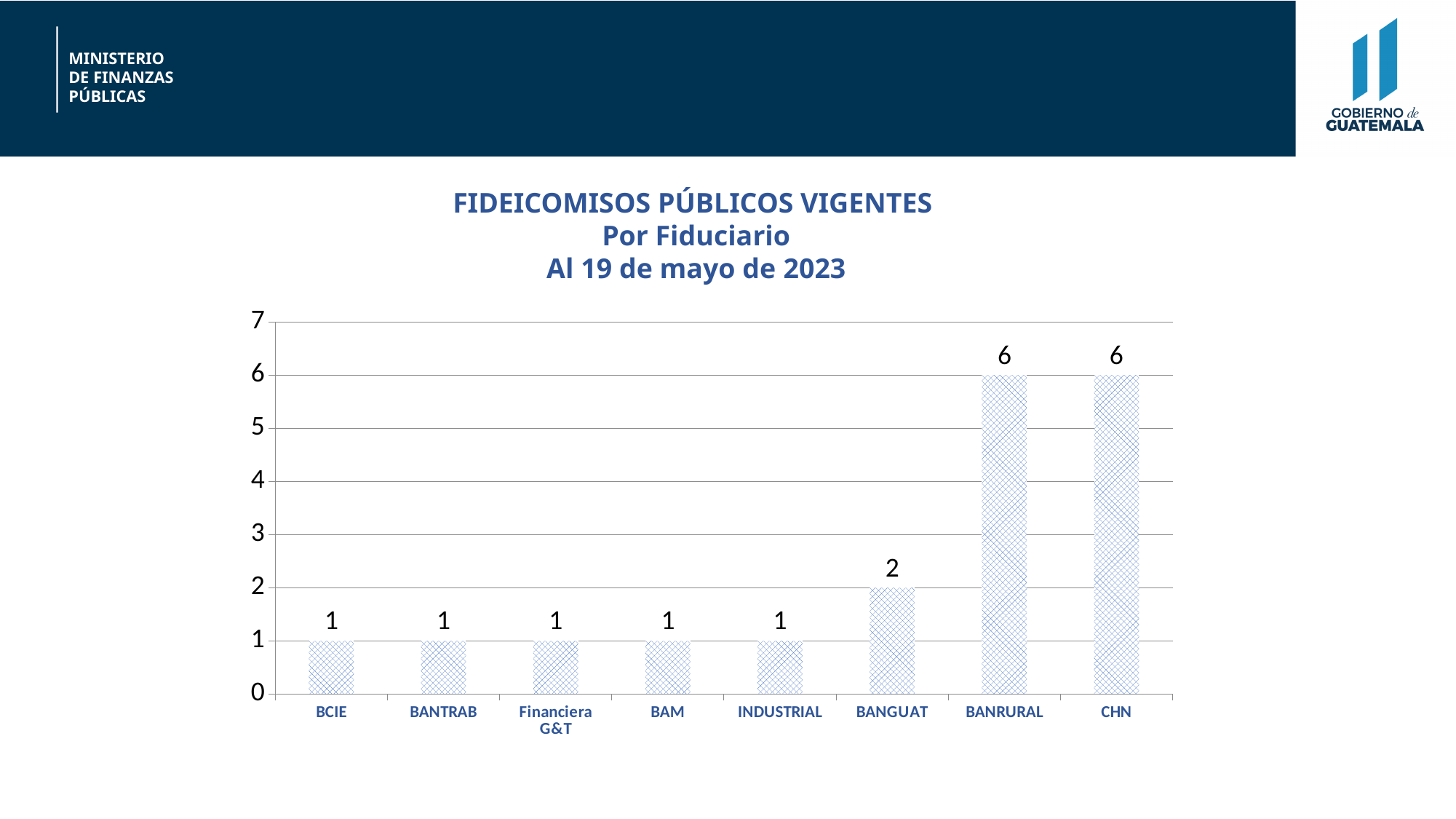
How many categories are shown on the x axis? 8 Which is larger, the value for BANGUAT or the value for BAM? BANGUAT What is the value for BANRURAL? 6 What is the value for Financiera G&T? 1 What is the title of the chart? FIDEICOMISOS PÚBLICOS VIGENTES Por Fiduciario Al 19 de mayo de 2023 What kind of chart is shown on the slide? bar chart Is the value for BANRURAL greater or less than 4? greater What is the value for BCIE? 1 What is the difference between the values for CHN and BANGUAT? 4 What is the value for BANGUAT? 2 What is the difference between the values for BANGUAT and INDUSTRIAL? 1 Which category has the lowest value among BANGUAT, BANRURAL and CHN? BANGUAT